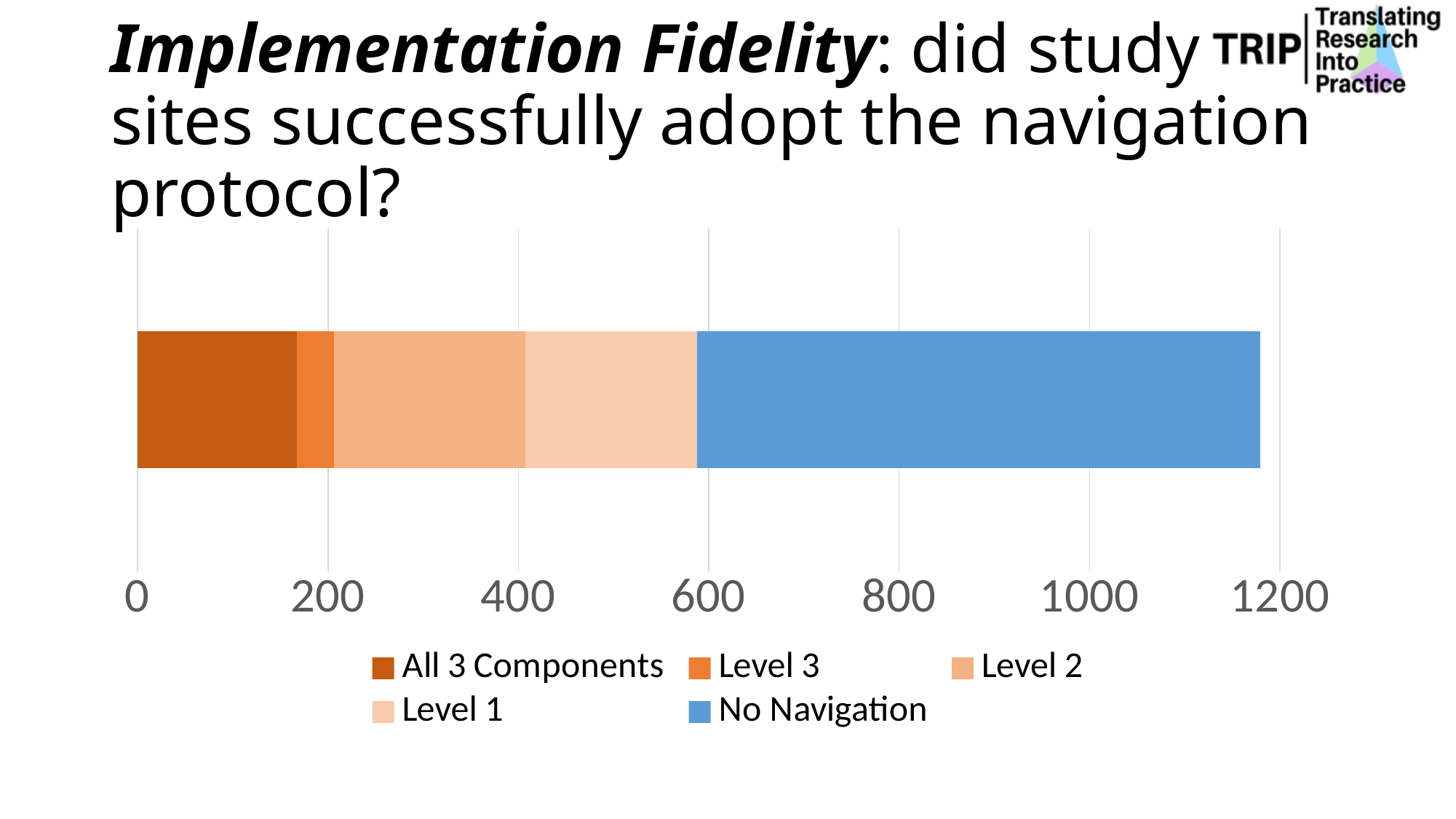
Which segment is larger, No Navigation or All 3 Components? No Navigation Which segment is larger, Level 2 or Level 3? Level 2 Is the value for No Navigation greater or less than 400? greater Is the value for All 3 Components greater or less than 200? less Which series has the largest segment in the bar? No Navigation How many series does the legend list? 5 How many bars are plotted in the chart? 1 Which series is shown in blue in the legend? No Navigation Which series has the smallest segment in the bar? Level 3 What kind of chart is shown on the slide? Stacked bar chart Is the value for Level 3 greater or less than 100? less